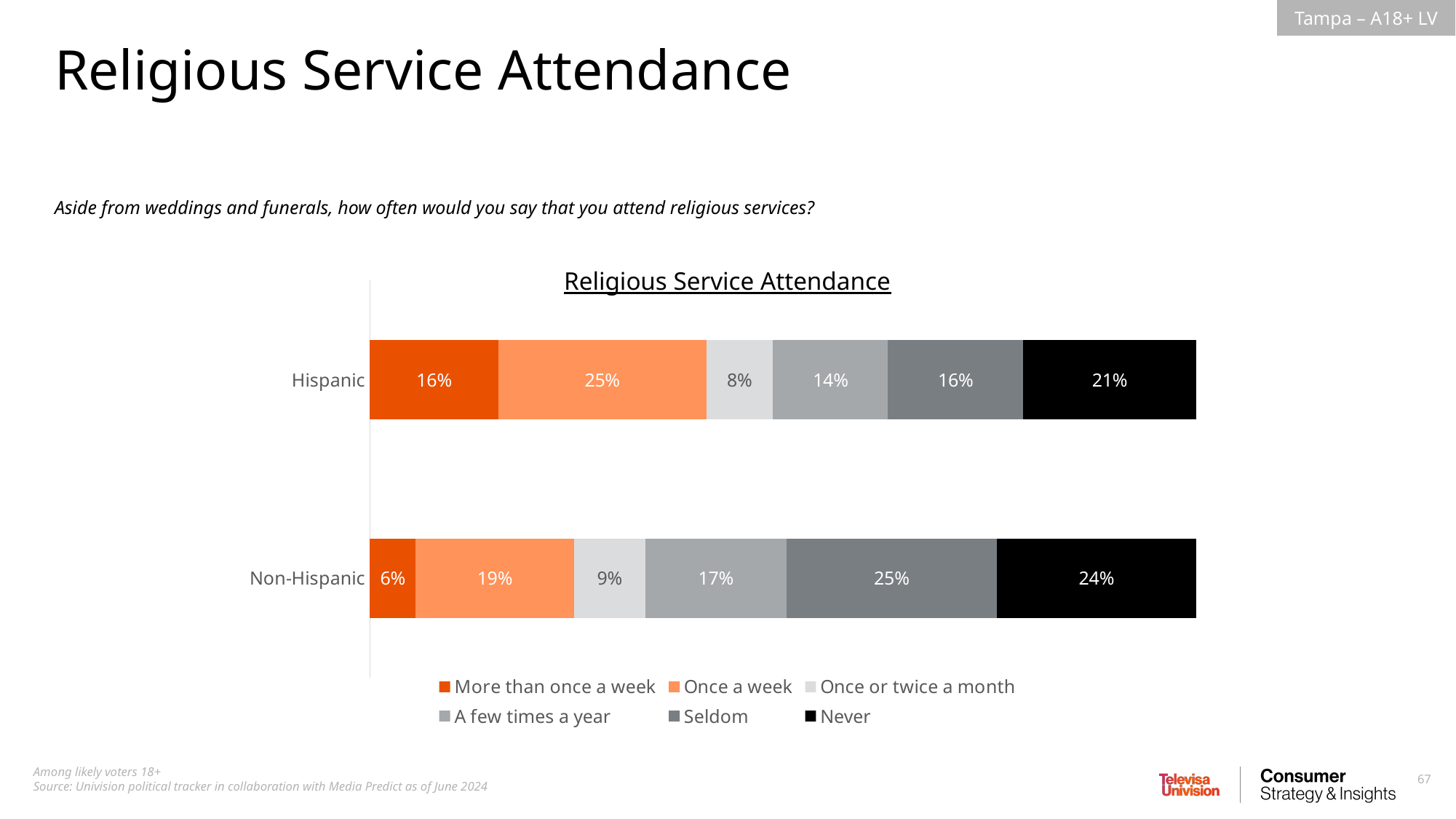
Which category has the largest share among Non-Hispanic respondents? Seldom How many groups (categories) are shown on the chart? 2 Which category has the smallest share among Hispanic respondents? Once or twice a month Which group has a higher percentage for 'Seldom', Hispanic or Non-Hispanic? Non-Hispanic What colour represents the 'Never' series in the chart? Black What percentage of Hispanic respondents attend religious services once a week? 25% What percentage of Hispanic respondents attend religious services a few times a year? 14% What is the difference between the Hispanic and Non-Hispanic percentages for 'More than once a week'? 10 percentage points What percentage of Non-Hispanic respondents attend religious services more than once a week? 6% How many series does the legend list? 6 What percentage of Non-Hispanic respondents say they never attend religious services? 24% What kind of chart is shown on the slide? Stacked bar chart